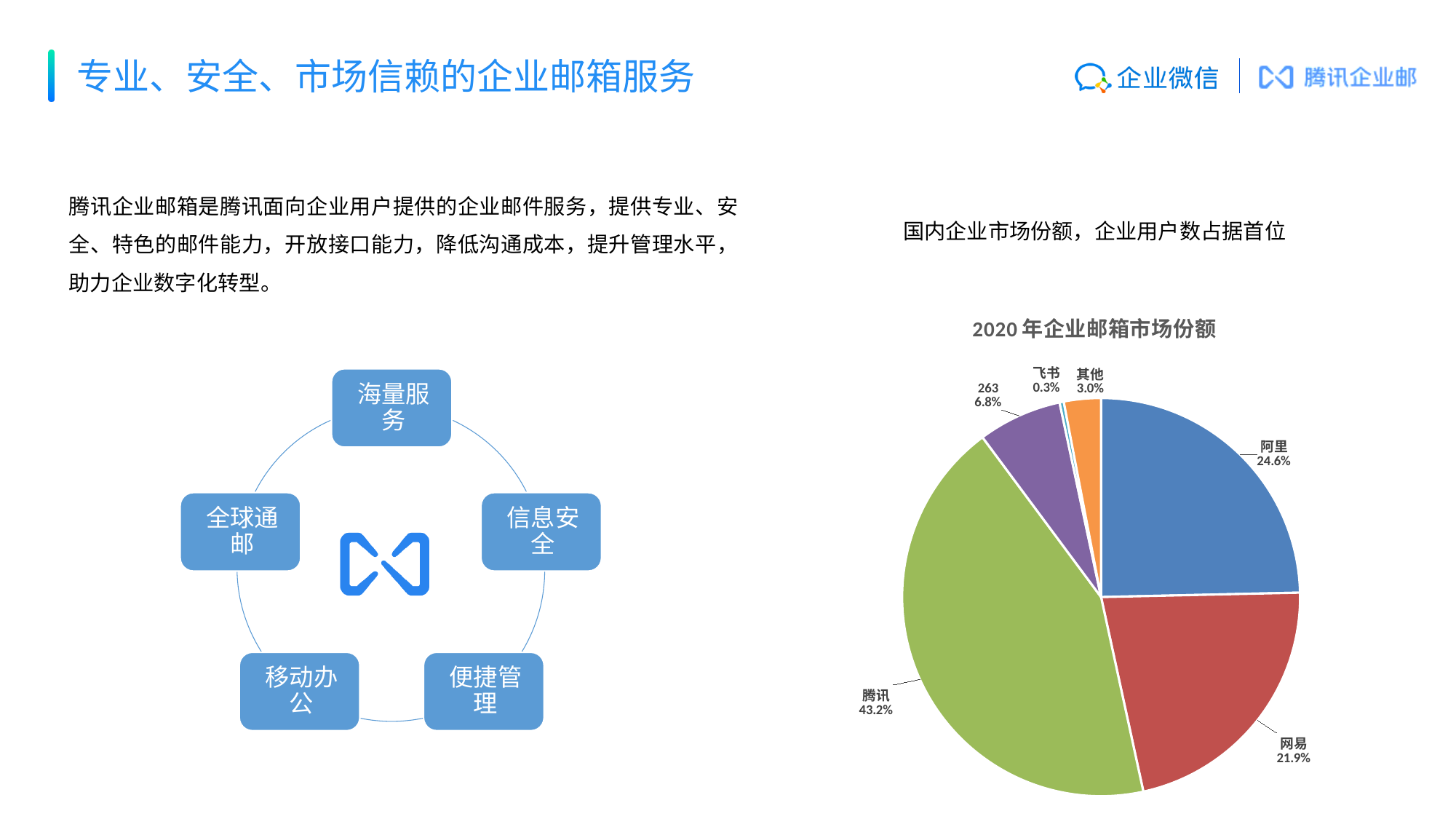
What kind of chart is shown on the slide? pie chart How many slices does the pie chart have? 6 Which company has the largest share in the pie chart? 腾讯 What is the market share of 网易? 21.9% Which company has the smallest share in the pie chart? 飞书 What is the difference between the shares of 腾讯 and 阿里? 18.6% What is the title of the chart? 2020 年企业邮箱市场份额 What is the market share of 飞书? 0.3% What is the market share of 腾讯? 43.2% What is the market share of 阿里? 24.6% What is the market share of 263? 6.8% Which has a larger share, 阿里 or 网易? 阿里